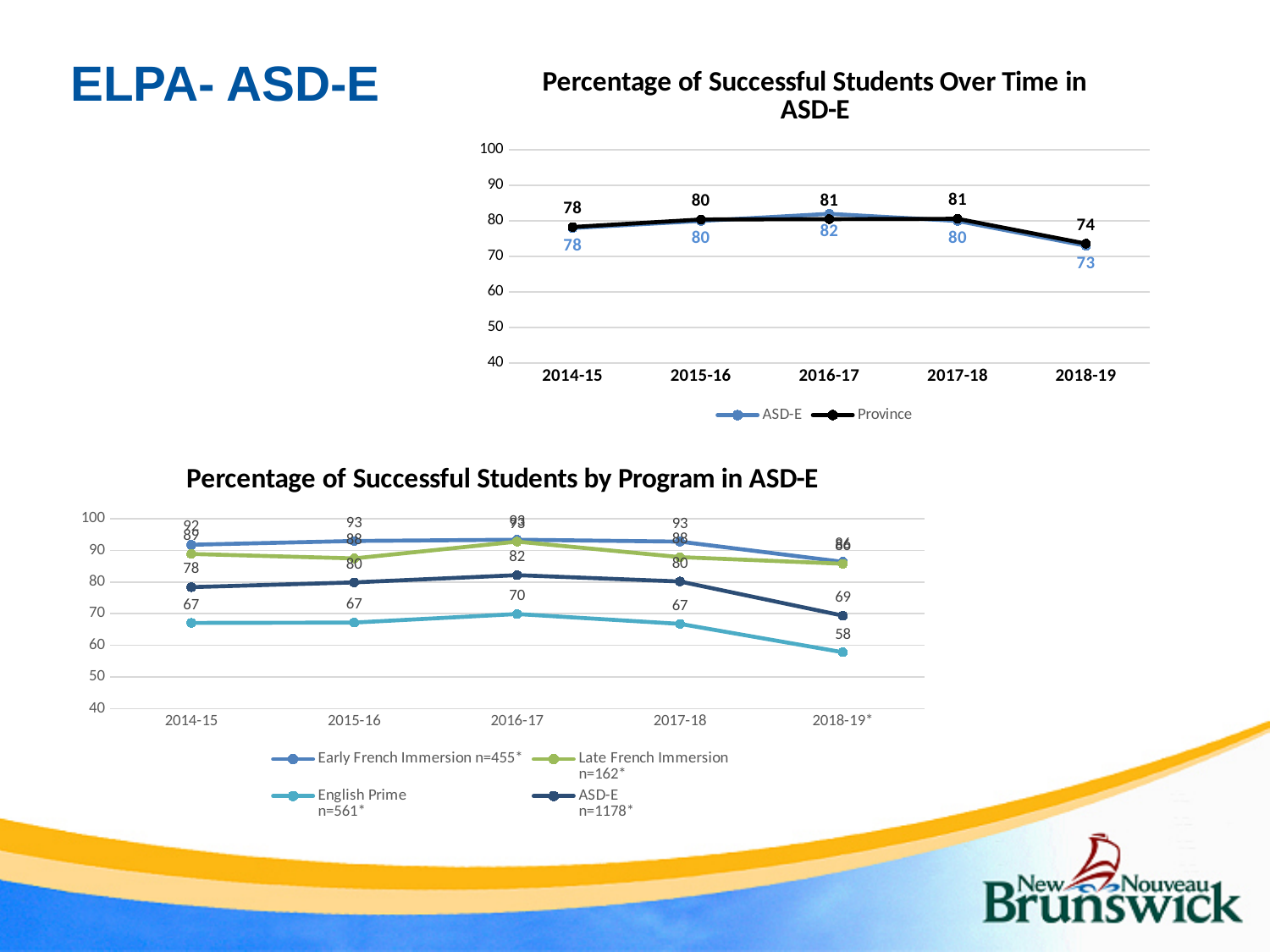
In the chart 'Percentage of Successful Students Over Time in ASD-E', how many series does the legend list? 2 What type of chart is 'Percentage of Successful Students Over Time in ASD-E'? Line chart In the chart 'Percentage of Successful Students by Program in ASD-E', is the Early French Immersion value for 2014-15 larger or smaller than the English Prime value for 2014-15? Larger In the chart 'Percentage of Successful Students by Program in ASD-E', what is the English Prime value for 2018-19*? 58 In the chart 'Percentage of Successful Students Over Time in ASD-E', what is the Province value for 2014-15? 78 In the chart 'Percentage of Successful Students Over Time in ASD-E', what is the ASD-E value for 2018-19? 73 In the chart 'Percentage of Successful Students Over Time in ASD-E', what is the difference between the Province value and the ASD-E value in 2018-19? 1 In the chart 'Percentage of Successful Students by Program in ASD-E', how many series does the legend list? 4 In the chart 'Percentage of Successful Students Over Time in ASD-E', which year has the lowest Province value? 2018-19 In the chart 'Percentage of Successful Students Over Time in ASD-E', what is the ASD-E value for 2016-17? 82 In the chart 'Percentage of Successful Students by Program in ASD-E', which year has the highest English Prime value? 2016-17 In the chart 'Percentage of Successful Students by Program in ASD-E', what is the ASD-E value for 2016-17? 82